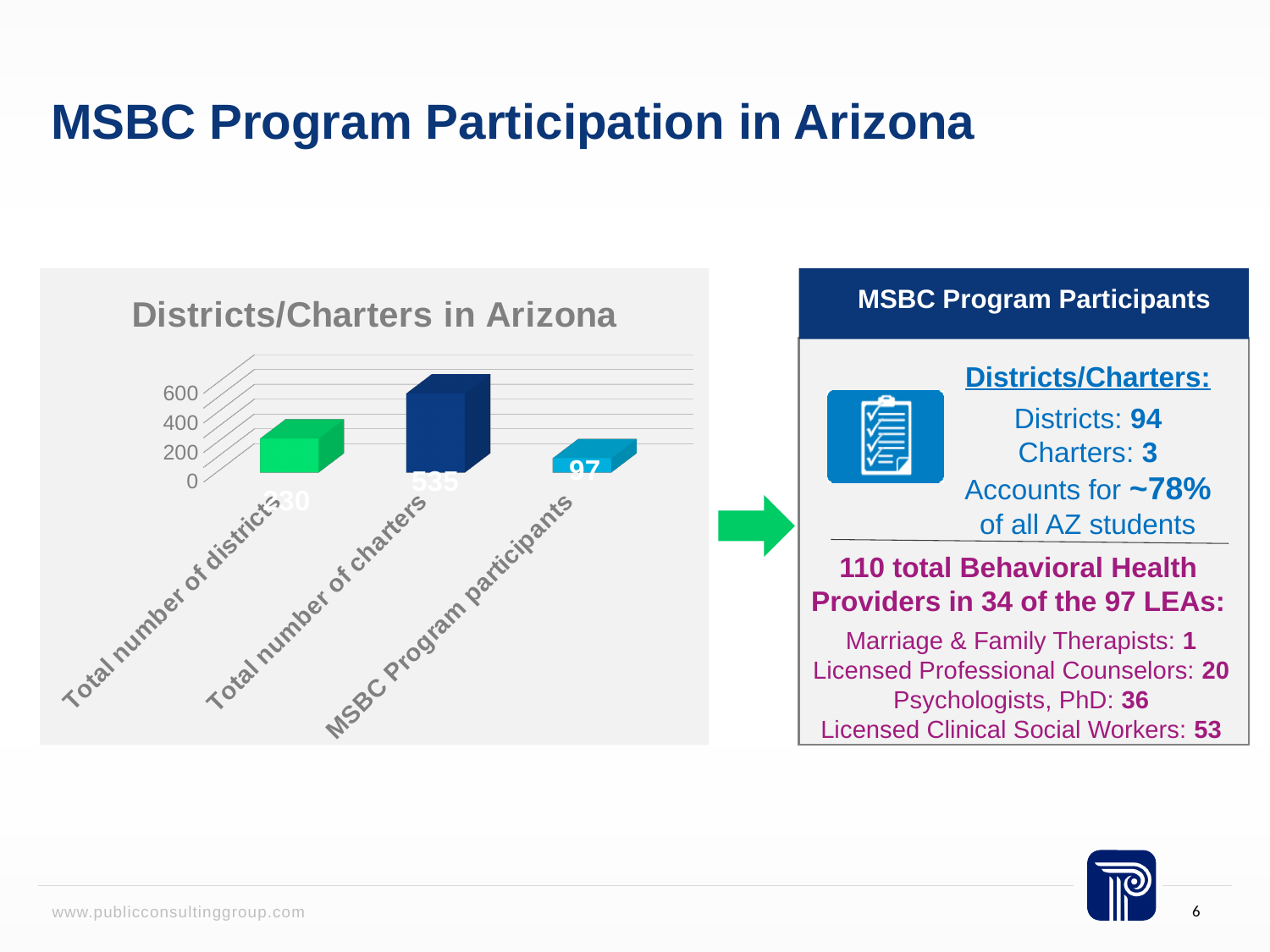
In the Districts/Charters in Arizona chart, which is larger: the total number of districts or the MSBC Program participants? Total number of districts What is the difference between the total number of charters and the total number of districts in the Districts/Charters in Arizona chart? 305 Which category has the highest value in the Districts/Charters in Arizona chart? Total number of charters What is the difference between the total number of districts and the MSBC Program participants in the Districts/Charters in Arizona chart? 133 Is the value for "Total number of charters" in the Districts/Charters in Arizona chart greater or less than 400? greater Which category has the lowest value in the Districts/Charters in Arizona chart? MSBC Program participants What is the title of the chart on the left side of the slide? Districts/Charters in Arizona What type of chart is shown under the title "Districts/Charters in Arizona"? Bar chart How many categories are shown in the Districts/Charters in Arizona chart? 3 What is the value for "Total number of charters" in the Districts/Charters in Arizona chart? 535 What is the value for "MSBC Program participants" in the Districts/Charters in Arizona chart? 97 What is the value for "Total number of districts" in the Districts/Charters in Arizona chart? 230